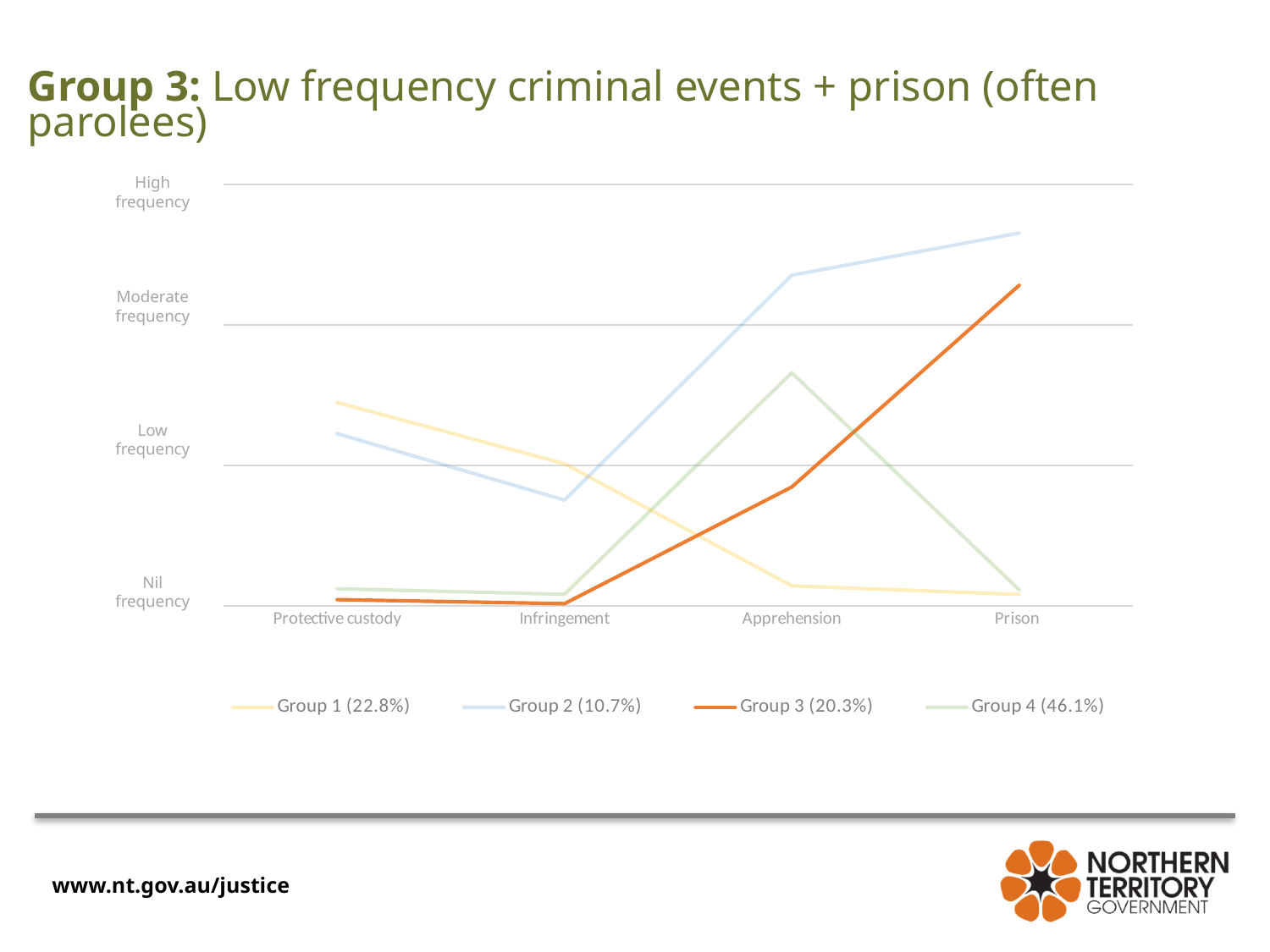
How many categories are shown along the x axis of the chart? 4 Which group has the highest value at Protective custody? Group 1 (22.8%) At Infringement, which is higher: Group 1 (22.8%) or Group 2 (10.7%)? Group 1 (22.8%) Which group has the highest value at Prison? Group 2 (10.7%) What kind of chart is shown on the slide? Line chart Which group has the lowest value at Apprehension? Group 1 (22.8%) At which category does the Group 4 (46.1%) line reach its highest point? Apprehension How many series does the chart's legend list? 4 At Prison, which is higher: Group 3 (20.3%) or Group 4 (46.1%)? Group 3 (20.3%) Does the Group 3 (20.3%) line rise or fall from Protective custody to Prison? Rise Does the Group 1 (22.8%) line rise or fall from Protective custody to Prison? Fall What percentage is shown in the legend for Group 4? 46.1%